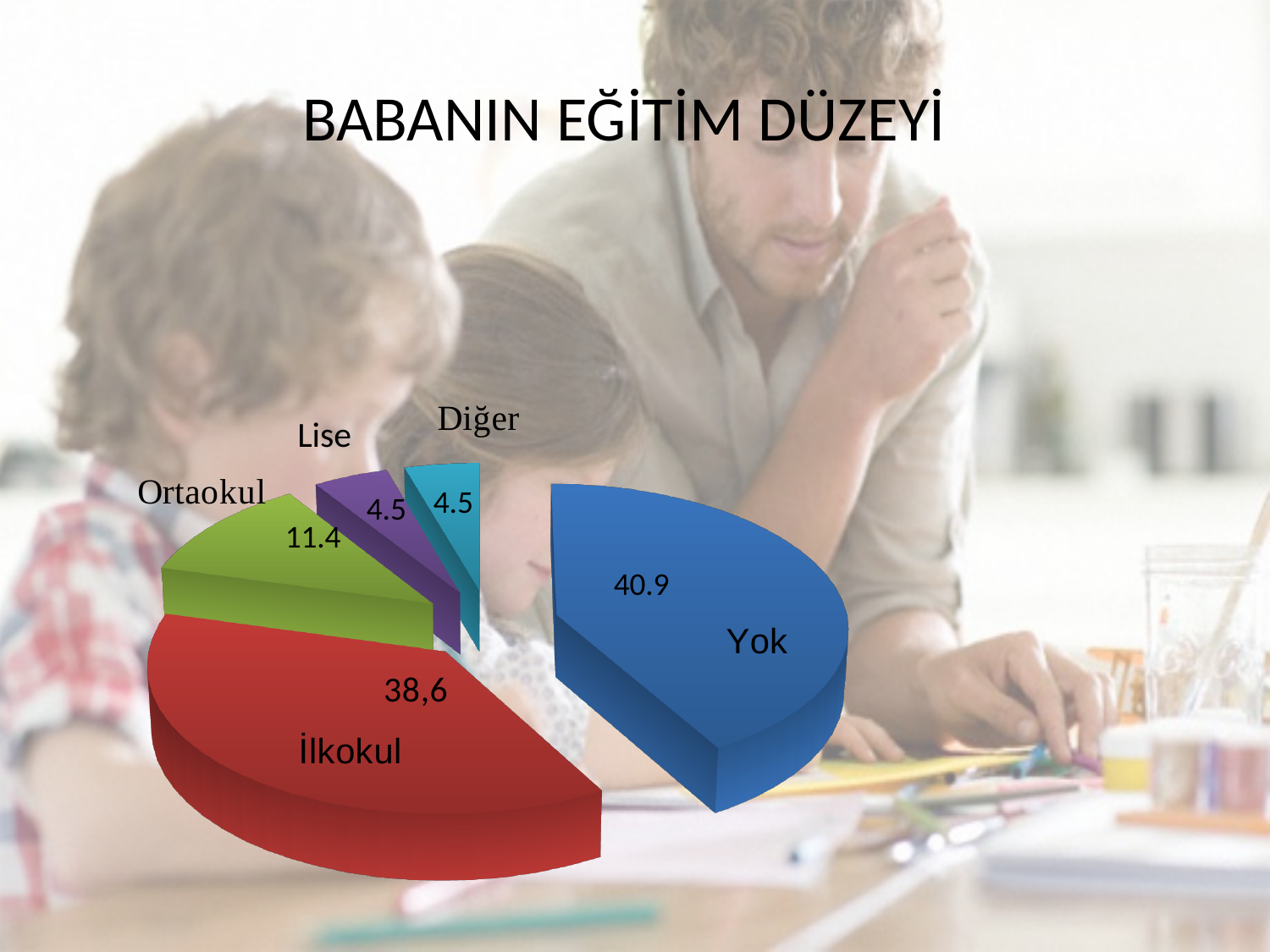
What is the value shown for the Diğer slice? 4.5 How many slices does the pie chart have? 5 What is the difference between the values for Ortaokul and Lise? 6.9 What is the value shown for the İlkokul slice? 38,6 What is the value shown for the Ortaokul slice? 11.4 What is the value shown for the Yok slice? 40.9 What is the difference between the values for Yok and İlkokul? 2.3 What is the value shown for the Lise slice? 4.5 What kind of chart is shown on the slide? Pie chart Which is larger, the value for Ortaokul or the value for Diğer? Ortaokul Which two categories share the smallest value in the pie? Lise and Diğer Which category has the largest slice of the pie? Yok